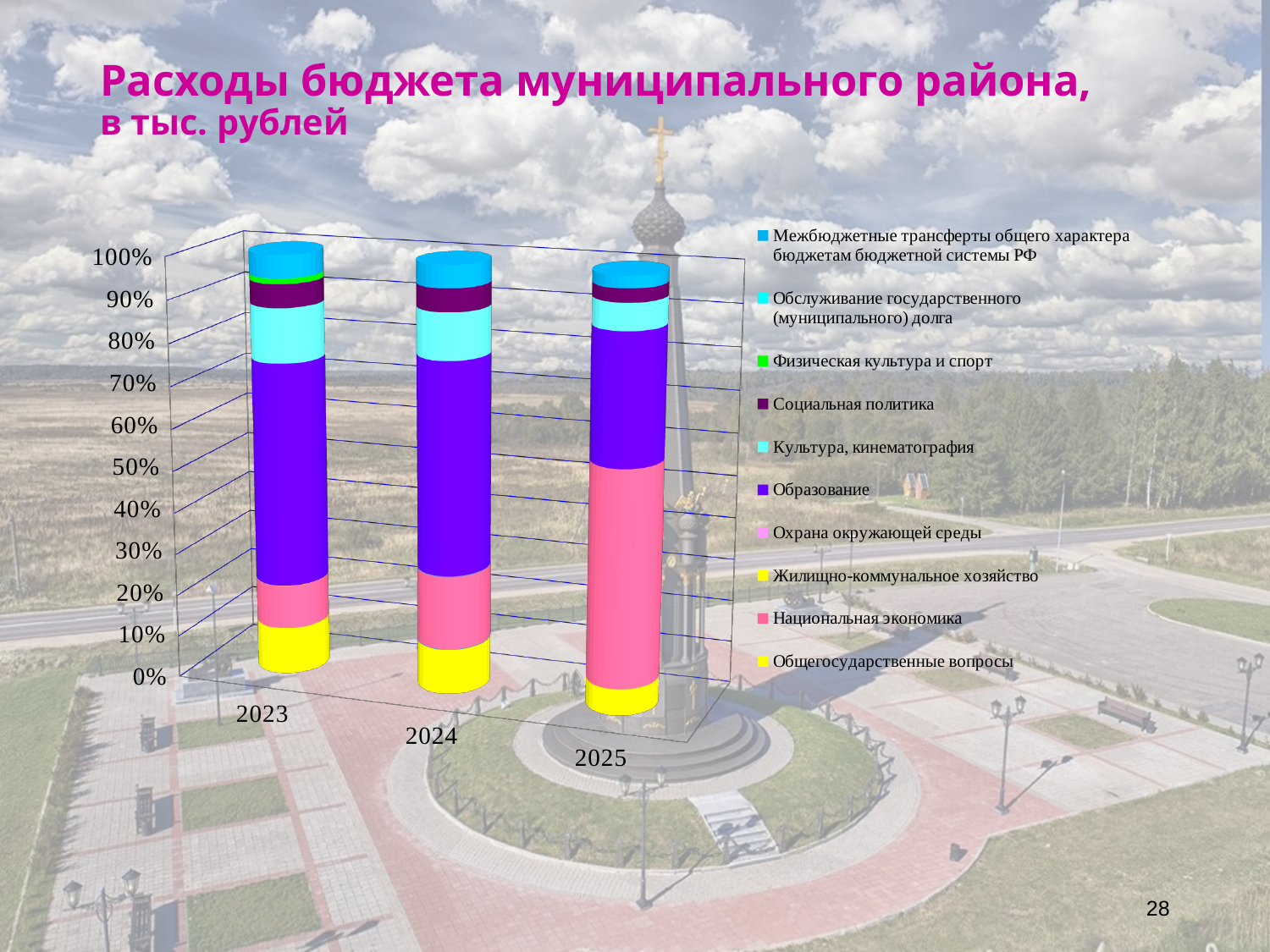
Which series takes the largest share of the 2025 bar? Национальная экономика How many series does the chart legend list? 10 What is the title of the chart on the slide? Расходы бюджета муниципального района, в тыс. рублей In 2025, which is larger: the share of Национальная экономика or the share of Образование? Национальная экономика Which series takes the largest share of the 2023 bar? Образование Does the share of Национальная экономика rise or fall from 2023 to 2025? rise How many years (categories) are shown on the x axis of the chart? 3 Is the share of Образование in 2023 greater or less than 40%? greater Which legend entry is listed last (at the bottom) in the chart legend? Общегосударственные вопросы In 2023, which is larger: the share of Образование or the share of Национальная экономика? Образование What kind of chart is shown on the slide? Stacked bar chart Is the share of Национальная экономика in 2025 greater or less than 30%? greater